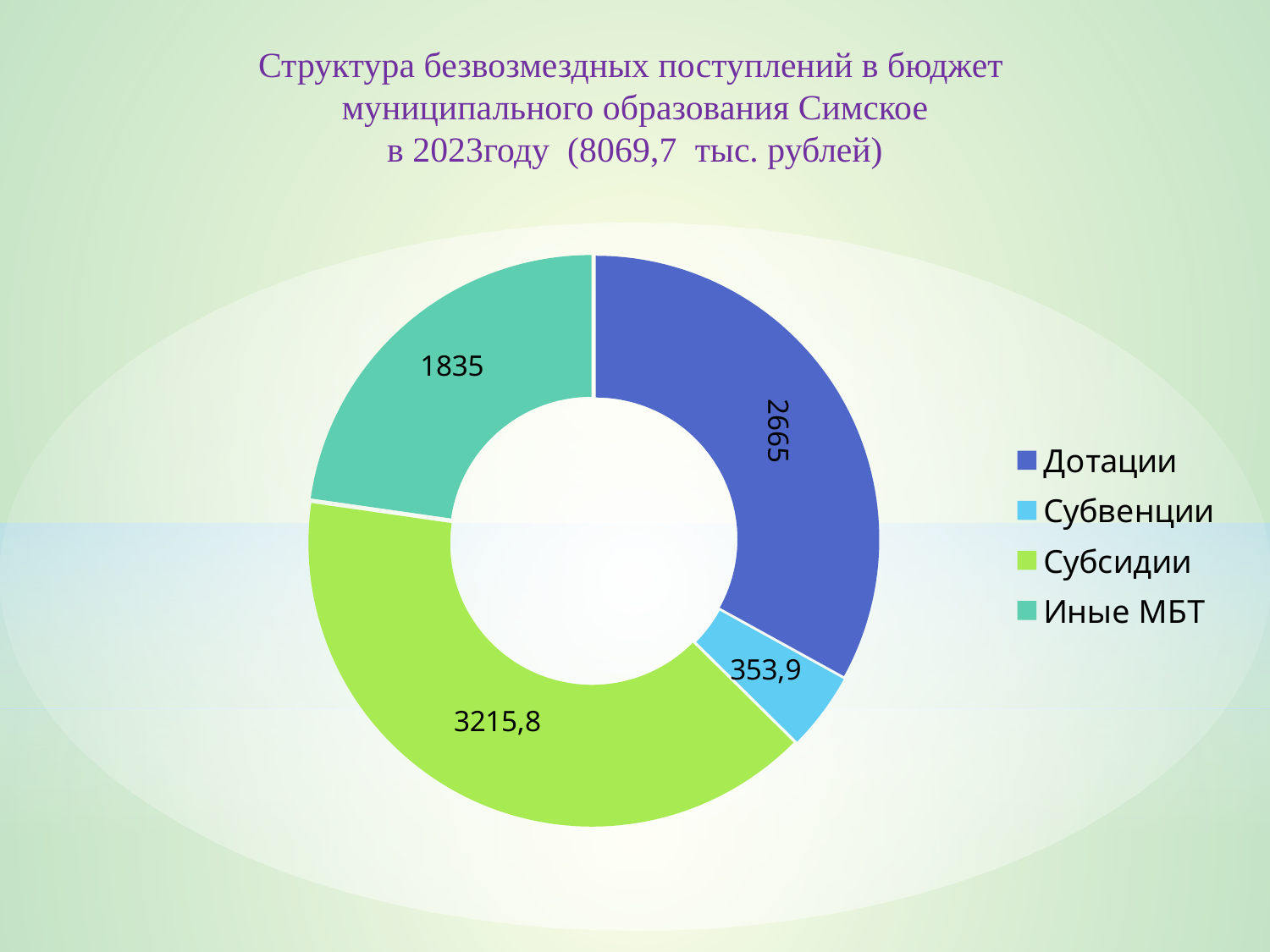
Which category has the smallest value? Субвенции What is the value for Иные МБТ? 1835 How many categories does the chart show? 4 What is the value for Субсидии? 3215,8 Which is larger, the value for Иные МБТ or the value for Субвенции? Иные МБТ What is the value for Дотации? 2665 What kind of chart is shown on the slide? doughnut chart What is the difference between the values for Субсидии and Дотации? 550,8 Which category has the largest value? Субсидии What is the difference between the values for Дотации and Иные МБТ? 830 What is the value for Субвенции? 353,9 What total amount in thousand rubles is stated in the chart title? 8069,7